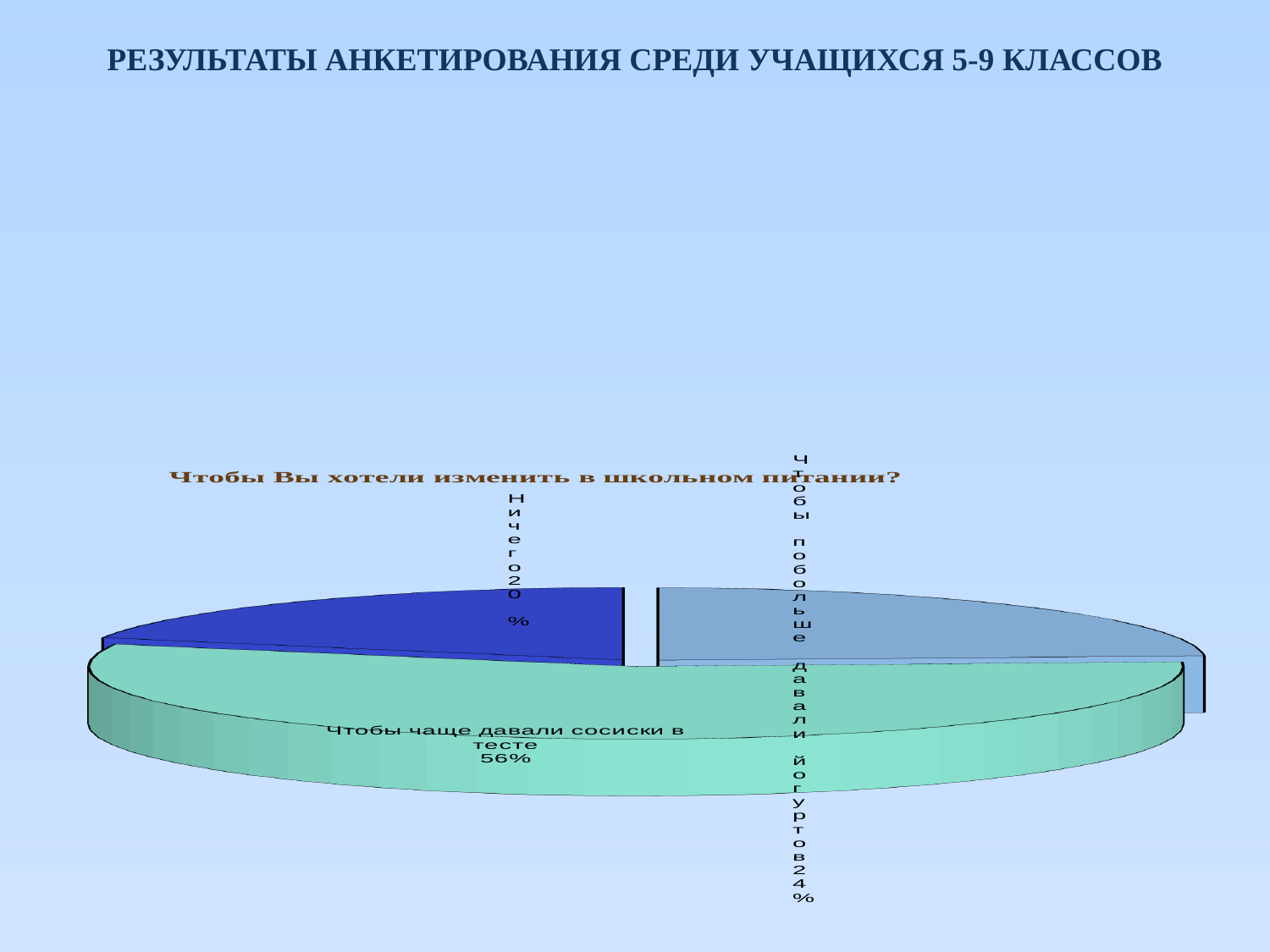
What is the title of the chart? Чтобы Вы хотели изменить в школьном питании? What is the difference in percentage points between "Чтобы чаще давали сосиски в тесте" and "Чтобы побольше давали йогуртов"? 32 What share of the pie is "Ничего"? 20% Which slice is the largest? Чтобы чаще давали сосиски в тесте Which slice is the smallest? Ничего Is the share for "Чтобы чаще давали сосиски в тесте" greater or less than 50%? greater What kind of chart is shown on the slide? pie chart What colour is the "Ничего" slice? dark blue How many slices does the pie chart have? 3 What share of the pie is "Чтобы чаще давали сосиски в тесте"? 56% What share of the pie is "Чтобы побольше давали йогуртов"? 24% Which is larger: "Чтобы побольше давали йогуртов" or "Ничего"? Чтобы побольше давали йогуртов